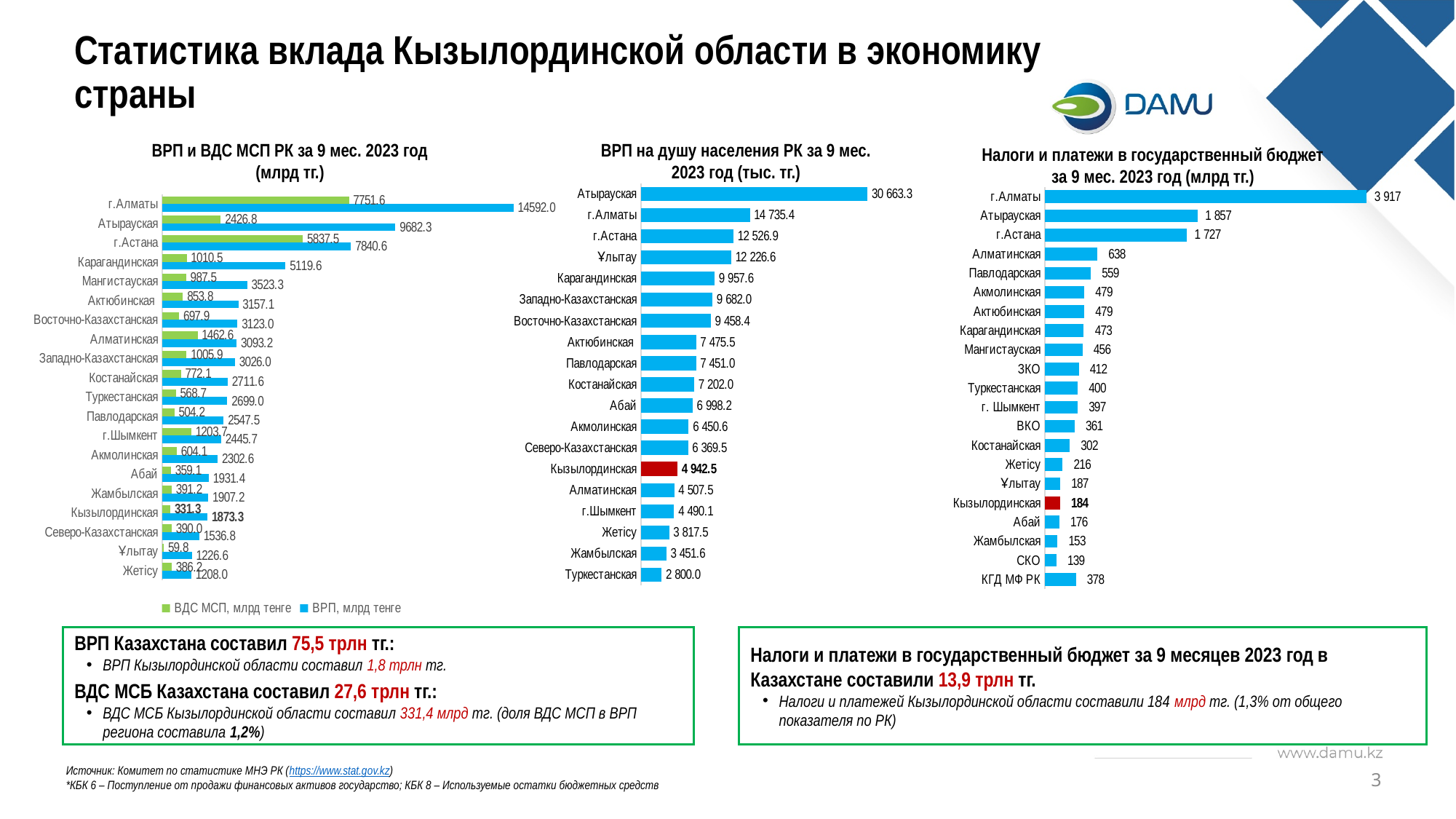
In the chart 'ВРП и ВДС МСП РК за 9 мес. 2023 год', which region has the highest ВРП value? г.Алматы In the chart 'Налоги и платежи в государственный бюджет за 9 мес. 2023 год', what is the value for Кызылординская? 184 In the chart 'ВРП на душу населения РК за 9 мес. 2023 год', what is the value for Кызылординская? 4 942.5 In the chart 'ВРП на душу населения РК за 9 мес. 2023 год', how many regions are plotted? 19 In the chart 'ВРП на душу населения РК за 9 мес. 2023 год', which region has the lowest value? Туркестанская What type of chart is 'Налоги и платежи в государственный бюджет за 9 мес. 2023 год'? Bar chart In the chart 'ВРП и ВДС МСП РК за 9 мес. 2023 год', how many series does the legend list? 2 In the chart 'ВРП и ВДС МСП РК за 9 мес. 2023 год', what is the ВРП value for Кызылординская? 1873.3 In the chart 'ВРП на душу населения РК за 9 мес. 2023 год', which is larger: the value for Ұлытау or for Карагандинская? Ұлытау In the chart 'ВРП и ВДС МСП РК за 9 мес. 2023 год', what is the ВДС МСП value for г.Астана? 5837.5 In the chart 'Налоги и платежи в государственный бюджет за 9 мес. 2023 год', what is the difference between the values for г.Алматы and Атырауская? 2 060 In the chart 'ВРП и ВДС МСП РК за 9 мес. 2023 год', what is the difference between the ВРП values of г.Алматы and Атырауская? 4909.7